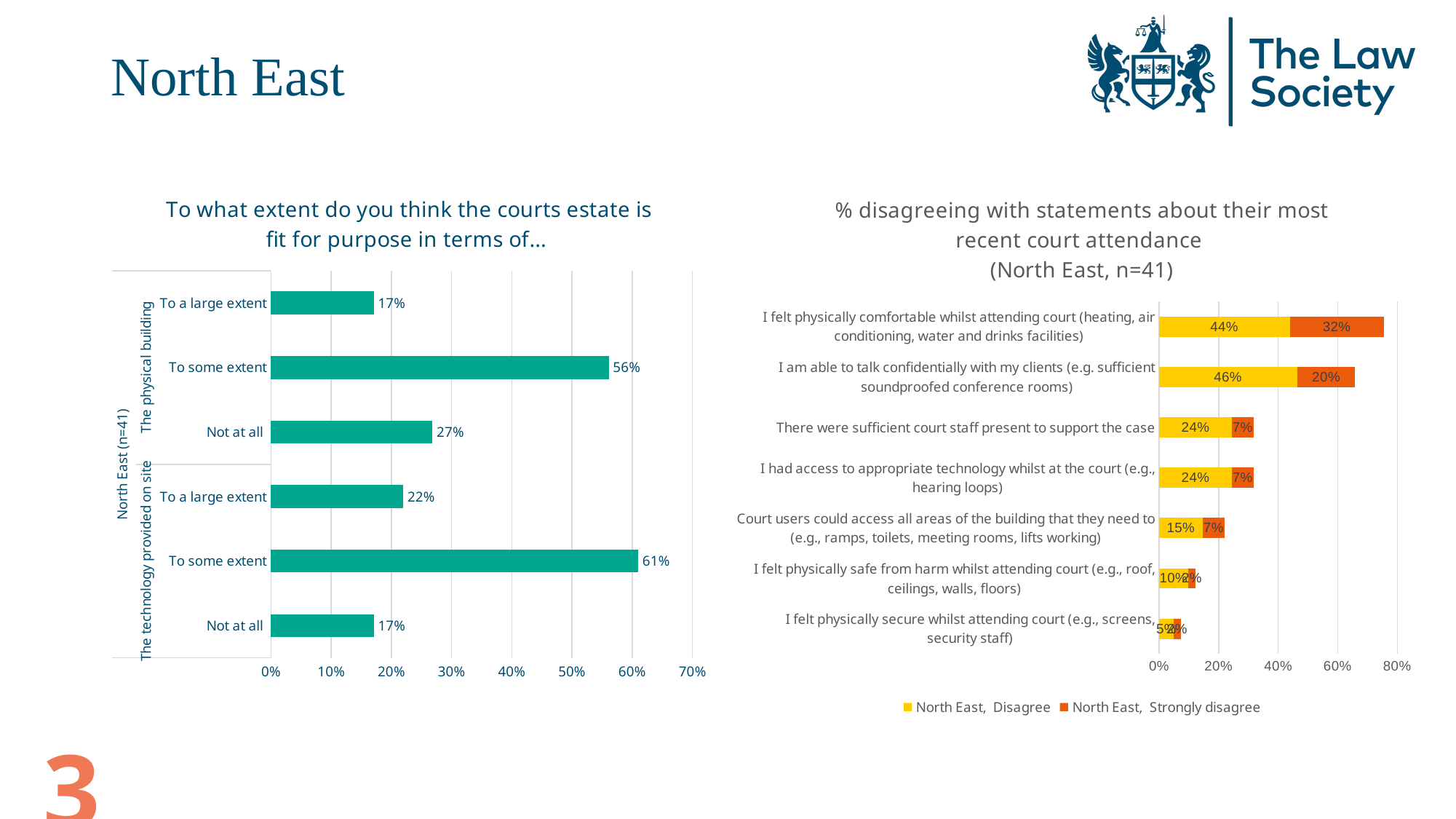
What kind of chart is the left chart 'To what extent do you think the courts estate is fit for purpose in terms of...'? Bar chart In the right chart '% disagreeing with statements about their most recent court attendance', what is the 'Disagree' value for 'I am able to talk confidentially with my clients'? 46% In the right chart '% disagreeing with statements about their most recent court attendance', how many series does the legend list? 2 In the left chart 'To what extent do you think the courts estate is fit for purpose in terms of...', what is the value for 'To some extent' under 'The technology provided on site'? 61% In the left chart 'To what extent do you think the courts estate is fit for purpose in terms of...', which bar has the highest value? To some extent (The technology provided on site) In the right chart '% disagreeing with statements about their most recent court attendance', which is larger: the 'Disagree' value for 'There were sufficient court staff present to support the case' or the 'Disagree' value for 'Court users could access all areas of the building that they need to'? There were sufficient court staff present to support the case In the right chart '% disagreeing with statements about their most recent court attendance', what is the 'Strongly disagree' value for 'I felt physically comfortable whilst attending court'? 32% In the left chart 'To what extent do you think the courts estate is fit for purpose in terms of...', what is the value for 'Not at all' under 'The physical building'? 27% In the right chart '% disagreeing with statements about their most recent court attendance', what is the total of the stacked bar for 'I felt physically comfortable whilst attending court'? 76% In the left chart 'To what extent do you think the courts estate is fit for purpose in terms of...', how many bars are plotted? 6 In the left chart 'To what extent do you think the courts estate is fit for purpose in terms of...', what is the difference between 'To some extent' and 'To a large extent' under 'The physical building'? 39% In the left chart 'To what extent do you think the courts estate is fit for purpose in terms of...', what is the value for 'To some extent' under 'The physical building'? 56%